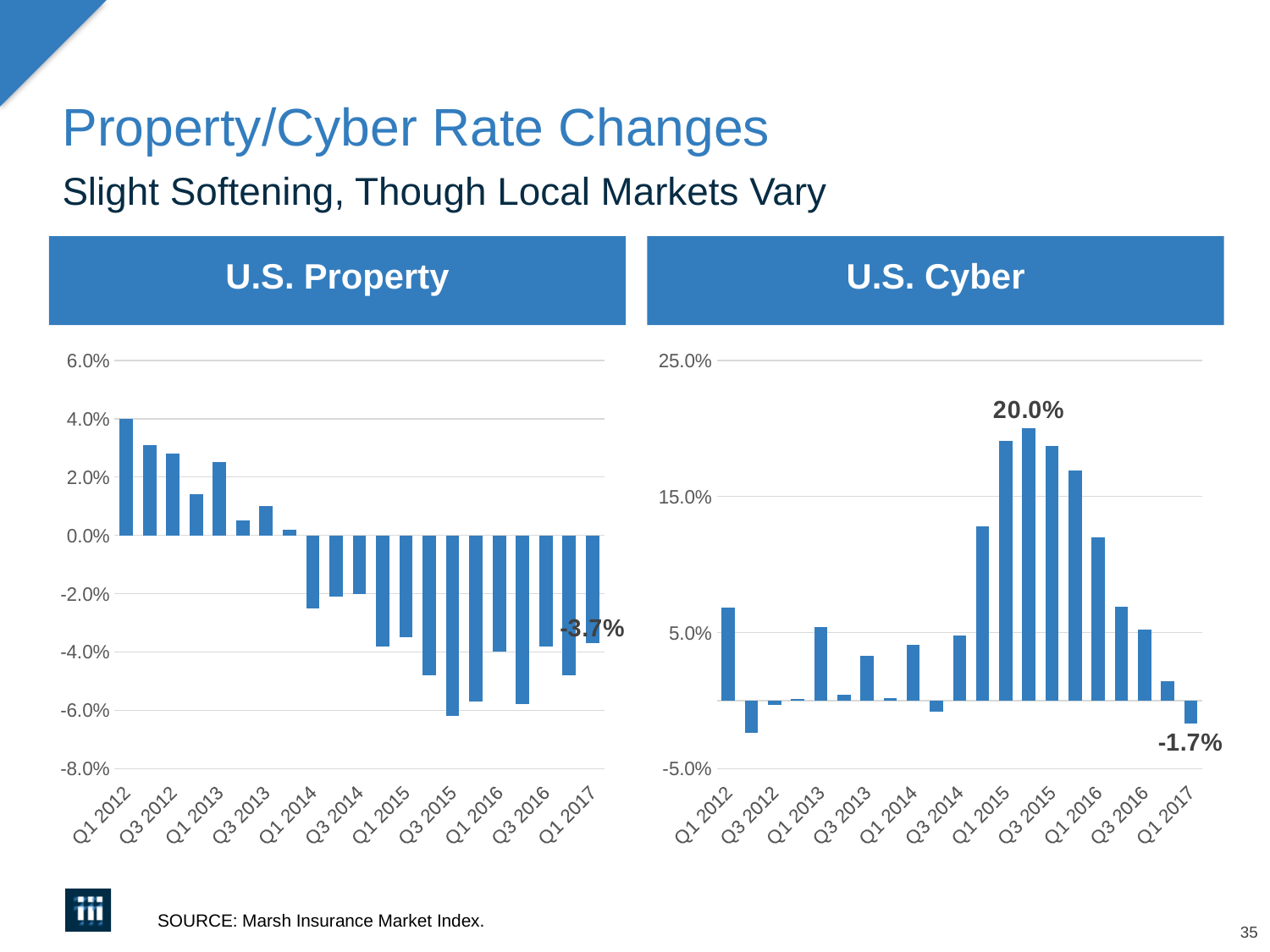
In the U.S. Property chart, which quarter has the highest rate change? Q1 2012 In the U.S. Cyber chart, what is the rate change shown for Q1 2017? -1.7% How many quarterly bars are plotted in the U.S. Property chart? 21 In the U.S. Cyber chart, do the values rise or fall from Q3 2015 to Q1 2017? Fall In the U.S. Cyber chart, is the value for Q1 2015 greater or less than 15.0%? greater In the U.S. Property chart, what is the rate change shown for Q1 2017? -3.7% In the U.S. Property chart, is the value for Q3 2015 greater or less than -6.0%? less In the U.S. Property chart, which quarter has the lowest rate change? Q3 2015 What kind of chart is the U.S. Cyber chart? Bar chart In the U.S. Cyber chart, what is the difference between the labeled peak value of 20.0% and the Q1 2017 value of -1.7%? 21.7 percentage points In the U.S. Cyber chart, which is larger, the value for Q1 2013 or the value for Q3 2013? Q1 2013 In the U.S. Cyber chart, what is the highest value labeled on the chart? 20.0%